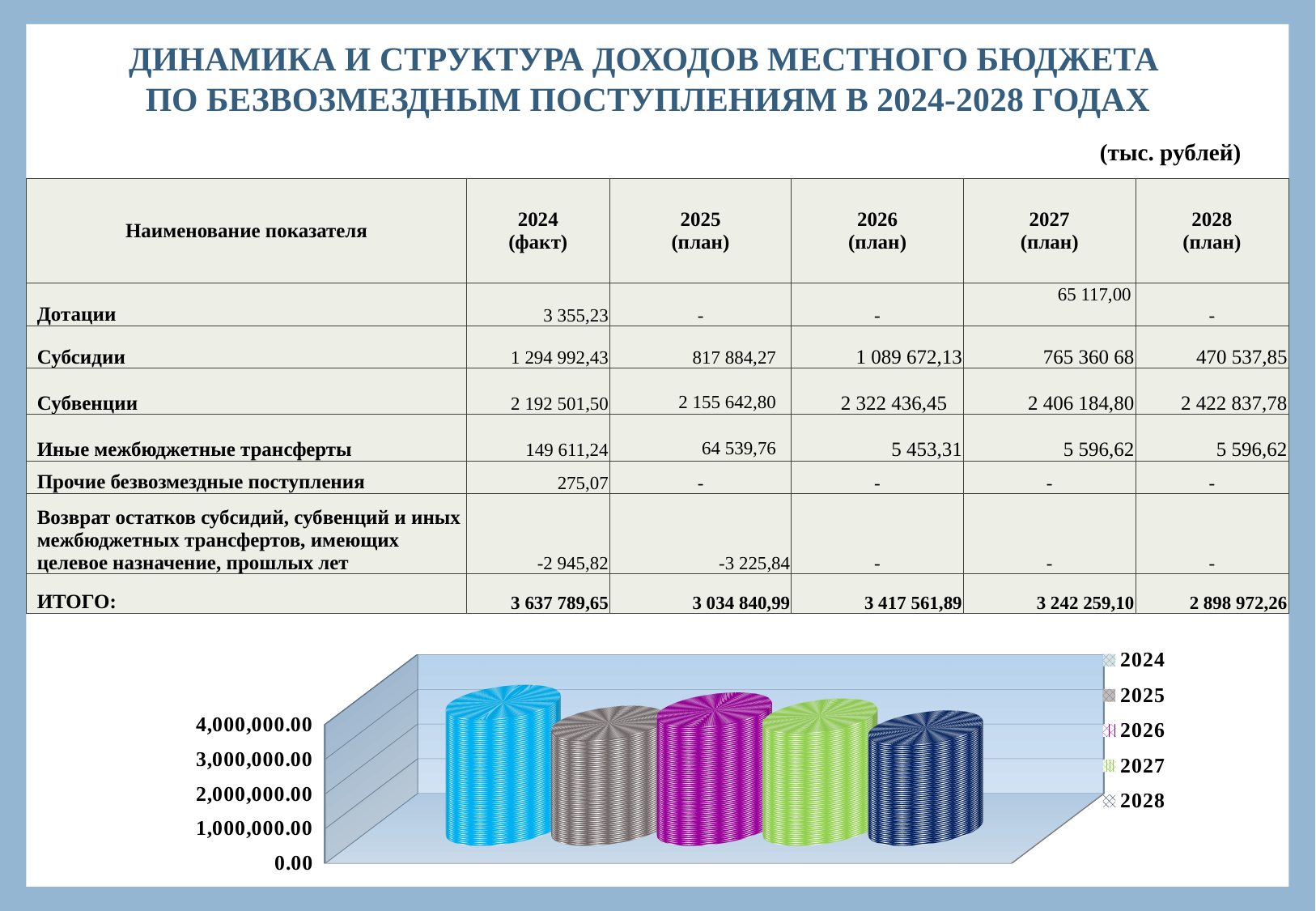
What is the highest value shown on the chart's vertical axis? 4,000,000.00 What kind of chart is shown at the bottom of the slide? bar chart Which bar is taller, 2024 or 2028? 2024 Which year has the tallest bar in the chart? 2024 How many entries does the chart legend list? 5 Which year does the magenta bar in the chart represent? 2026 Is the bar for 2028 greater or less than 2,000,000.00? greater Overall, do the bars rise or fall from 2024 to 2028? fall Is the bar for 2024 greater or less than 3,000,000.00? greater How many bars are plotted in the chart? 5 Is the bar for 2025 greater or less than 2,000,000.00? greater